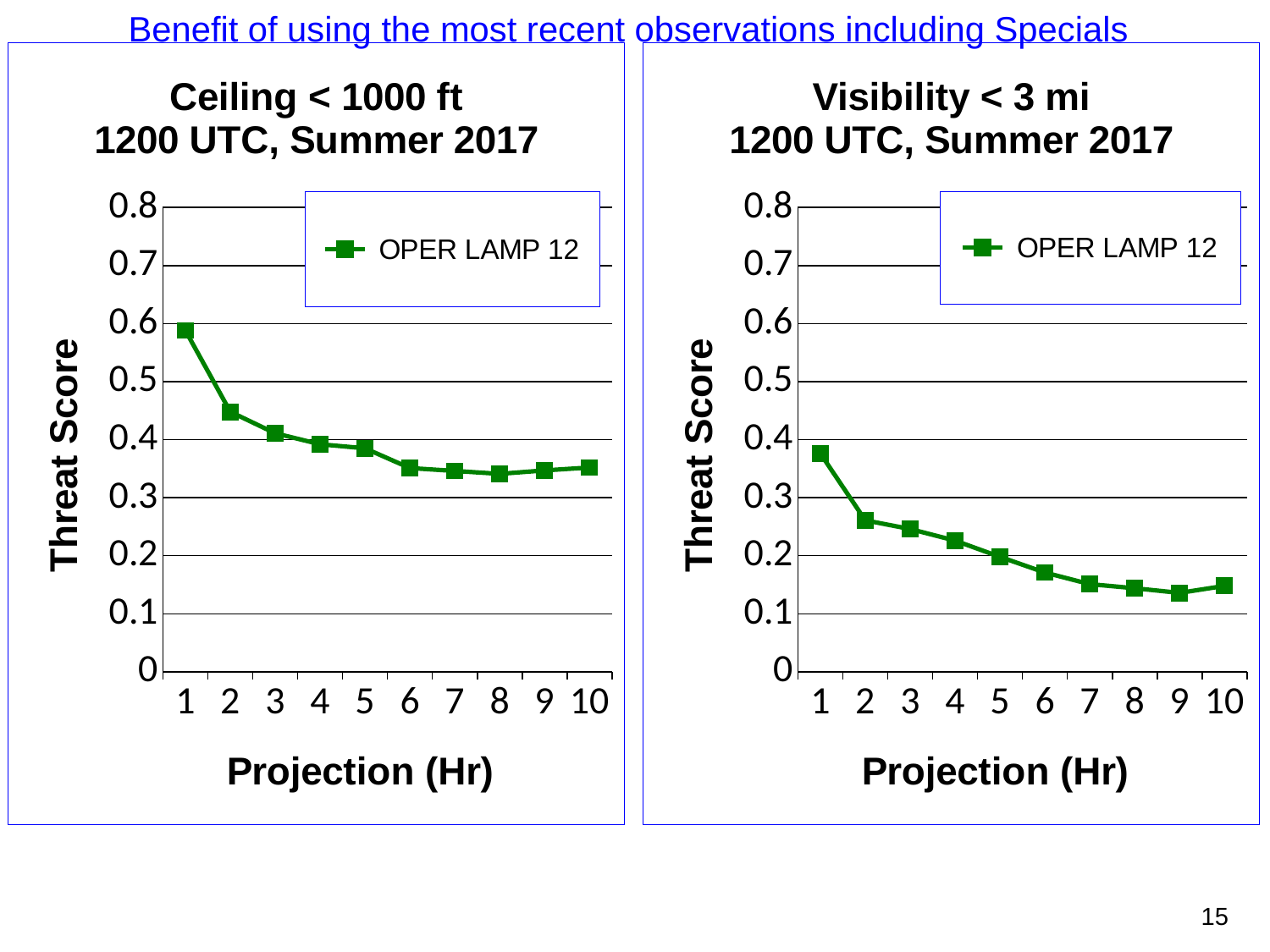
In the 'Visibility < 3 mi' chart, at which projection hour is the threat score highest? 1 What is the name of the series shown in the legend of the 'Visibility < 3 mi' chart? OPER LAMP 12 In the 'Visibility < 3 mi' chart, does the threat score generally rise or fall as the projection hour increases? fall In the 'Ceiling < 1000 ft' chart, which projection hour has the larger threat score, hour 2 or hour 6? hour 2 In the 'Ceiling < 1000 ft' chart, is the threat score at projection hour 1 greater or less than 0.5? greater In the 'Visibility < 3 mi' chart, is the threat score at projection hour 1 greater or less than 0.4? less What kind of chart is the 'Ceiling < 1000 ft' chart on the left? line chart In the 'Ceiling < 1000 ft' chart, is the threat score at projection hour 10 greater or less than 0.4? less How many series does the legend of the 'Ceiling < 1000 ft' chart list? 1 In the 'Visibility < 3 mi' chart on the right, how many projection hours are plotted along the x axis? 10 In the 'Ceiling < 1000 ft' chart, at which projection hour is the threat score highest? 1